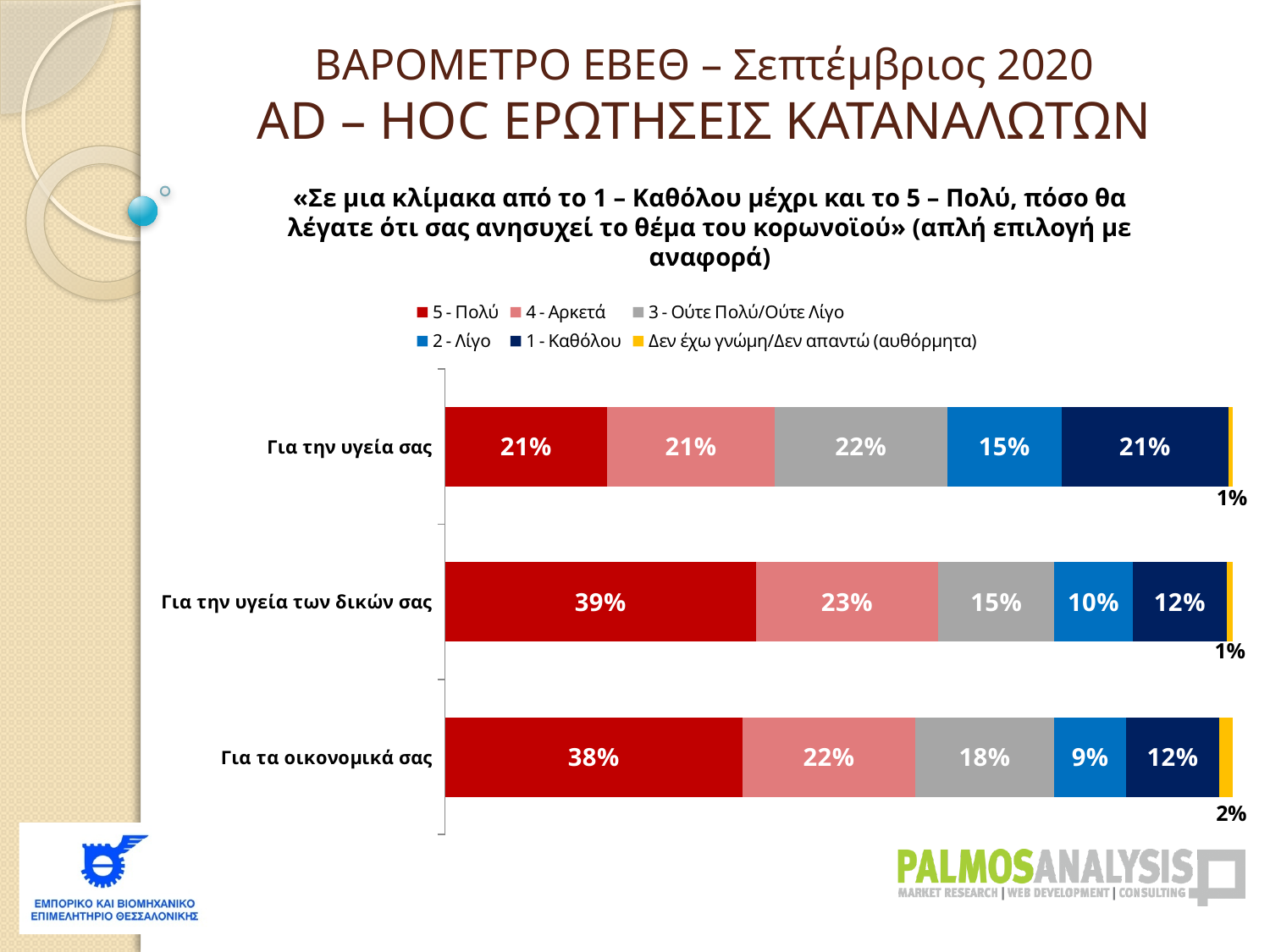
What is the value of "3 - Ούτε Πολύ/Ούτε Λίγο" for "Για την υγεία σας"? 22% How many series does the legend list? 6 What is the value of "5 - Πολύ" for "Για την υγεία των δικών σας"? 39% Which series is shown in yellow in the legend? Δεν έχω γνώμη/Δεν απαντώ (αυθόρμητα) What is the value of "Δεν έχω γνώμη/Δεν απαντώ (αυθόρμητα)" for "Για τα οικονομικά σας"? 2% What is the value of "2 - Λίγο" for "Για τα οικονομικά σας"? 9% Which category has the highest value for "5 - Πολύ"? Για την υγεία των δικών σας Which is larger: the "4 - Αρκετά" value for "Για την υγεία των δικών σας" or for "Για τα οικονομικά σας"? Για την υγεία των δικών σας How many categories are plotted on the chart? 3 What is the difference between the "5 - Πολύ" values for "Για την υγεία των δικών σας" and "Για την υγεία σας"? 18% What kind of chart is shown on the slide? Stacked bar chart